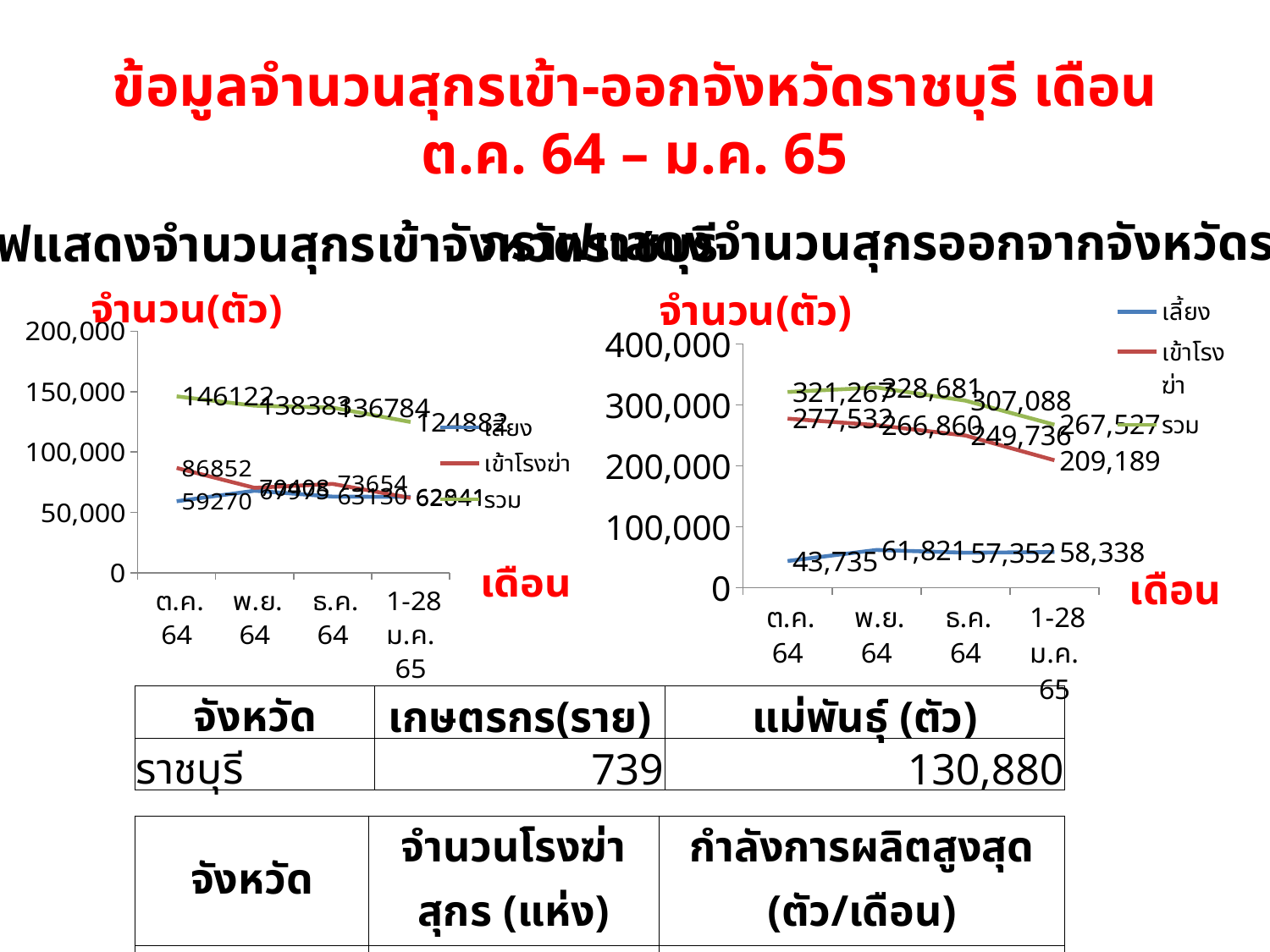
In the left chart, what is the difference between the รวม values for ต.ค. 64 and 1-28 ม.ค. 65? 21240 In the right chart, what is the value of the รวม series for ต.ค. 64? 321,267 In the left chart, what is the value of the เข้าโรงฆ่า series for ต.ค. 64? 86852 In the right chart, what is the value of the เข้าโรงฆ่า series for 1-28 ม.ค. 65? 209,189 In the right chart, does the เข้าโรงฆ่า series rise or fall from ต.ค. 64 to 1-28 ม.ค. 65? fall In the right chart, what is the difference between the เข้าโรงฆ่า values for ต.ค. 64 and 1-28 ม.ค. 65? 68,343 In the right chart, which month has the lowest value for the เลี้ยง series? ต.ค. 64 In the right chart, which month has the highest value for the รวม series? พ.ย. 64 What type of chart is the left chart? line chart In the right chart, what is the value of the เลี้ยง series for พ.ย. 64? 61,821 How many series does the legend of the right chart list? 3 In the left chart, what is the value of the รวม series for ต.ค. 64? 146122